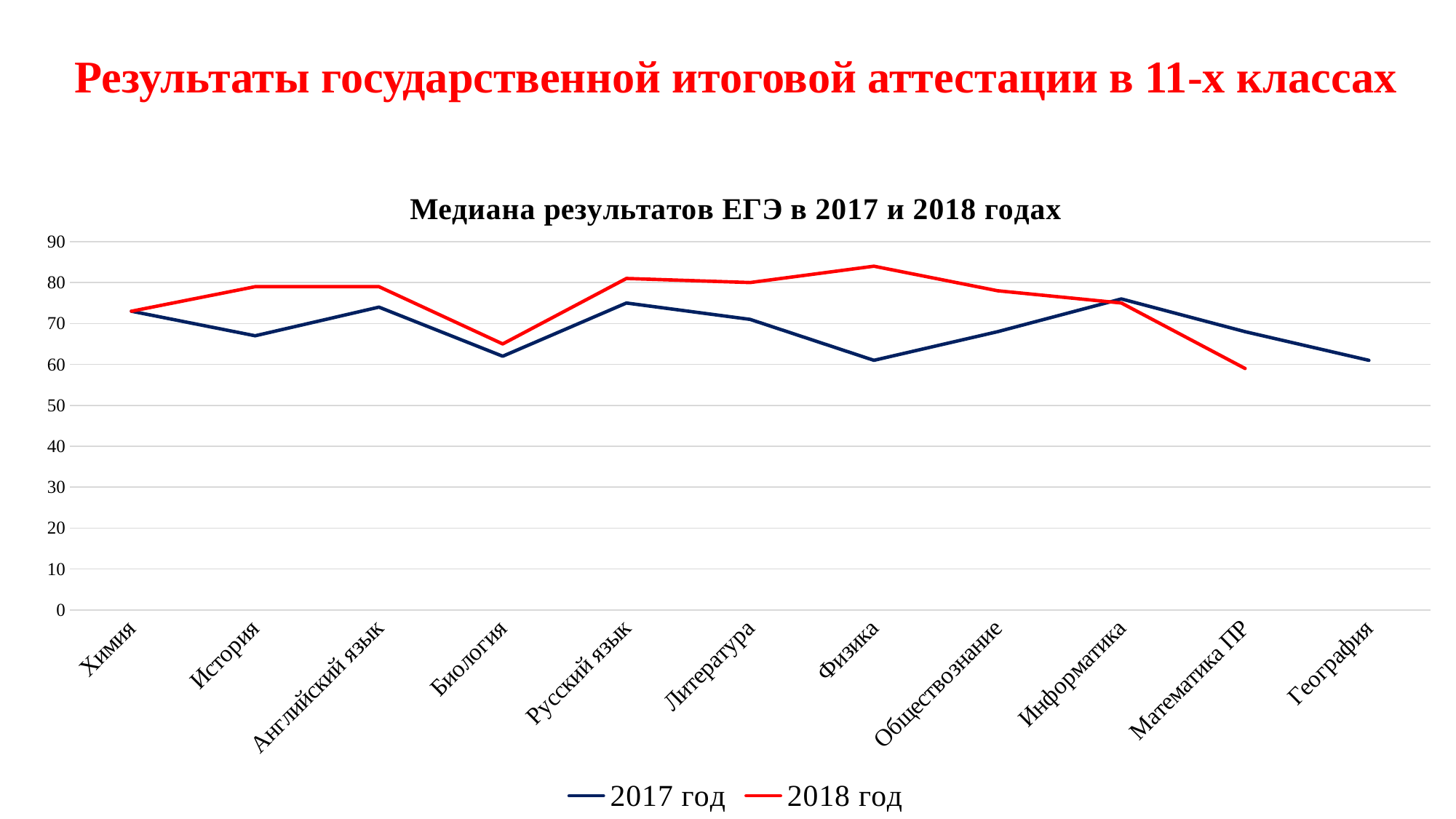
Which subject has the lowest value for the 2018 год series? Математика ПР For Математика ПР, which series has the larger value, 2017 год or 2018 год? 2017 год Is the 2018 год value for Математика ПР greater or less than 70? less Which subject has the highest value for the 2018 год series? Физика Is the 2017 год value for История greater or less than 70? less Is the 2017 год value for Биология greater or less than 70? less Does the 2018 год line rise or fall from Физика to Математика ПР? fall For Физика, which series has the larger value, 2017 год or 2018 год? 2018 год How many series does the legend list? 2 How many subjects are listed along the x axis? 11 What kind of chart is shown on the slide? line chart